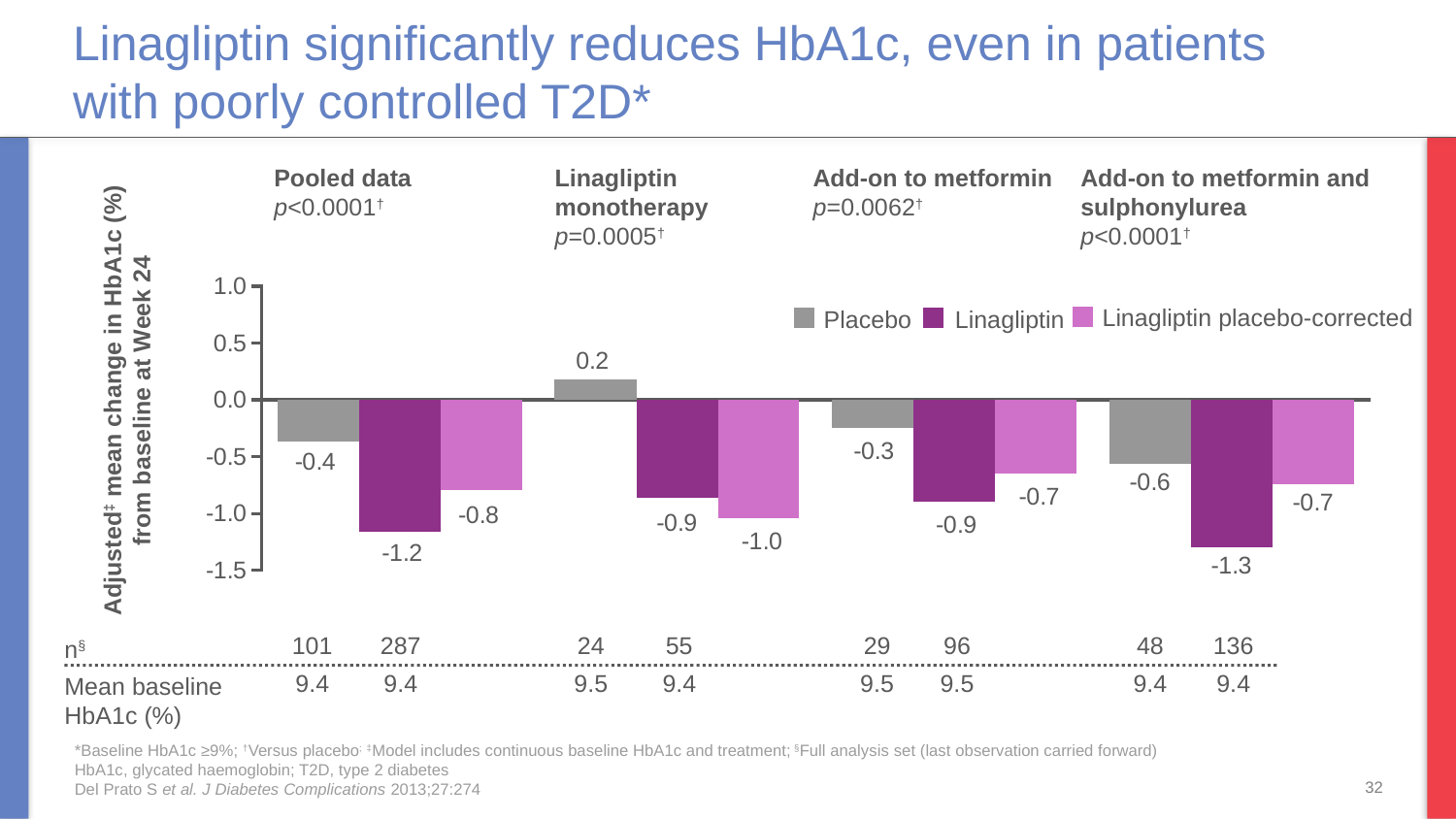
In which group does Linagliptin show the largest reduction in HbA1c (lowest value)? Add-on to metformin and sulphonylurea What is the Placebo value in the Linagliptin monotherapy group? 0.2 What is the Linagliptin placebo-corrected value in the Add-on to metformin group? -0.7 What is the difference between the Placebo and Linagliptin values in the Pooled data group? 0.8 What is the adjusted mean change in HbA1c for Linagliptin in the Pooled data group? -1.2 How many treatment groups are shown on the x axis of the chart? 4 What is the Linagliptin value in the Add-on to metformin and sulphonylurea group? -1.3 What colour represents the Placebo series in the chart? Grey What kind of chart is shown on the slide? Bar chart How many series does the legend list? 3 Which series has the highest value in the Linagliptin monotherapy group? Placebo Which is lower, the Linagliptin value in the Pooled data group or the Linagliptin value in the Add-on to metformin group? Pooled data